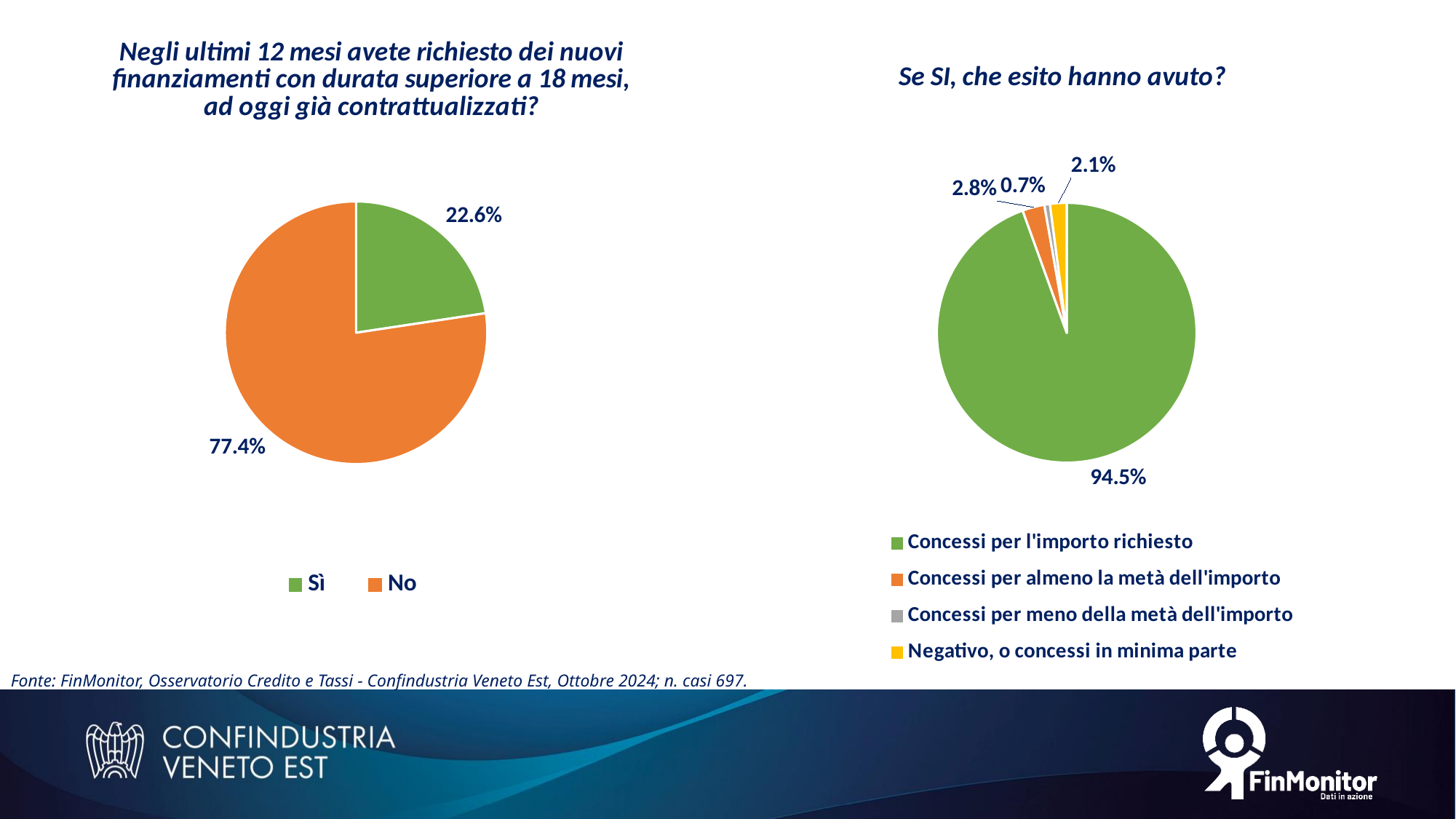
In the right pie chart, which category has the smallest share? Concessi per meno della metà dell'importo In the left pie chart, what percentage of respondents answered 'Sì'? 22.6% What type of chart is used on the left side of the slide? Pie chart In the right pie chart ('Se SI, che esito hanno avuto?'), what is the share for 'Concessi per l'importo richiesto'? 94.5% In the right pie chart, what is the share for 'Negativo, o concessi in minima parte'? 2.1% In the right pie chart, which is larger: 'Concessi per almeno la metà dell'importo' or 'Negativo, o concessi in minima parte'? Concessi per almeno la metà dell'importo In the left pie chart, which colour represents 'No'? Orange How many categories does the legend of the right pie chart list? 4 In the right pie chart, what is the share for 'Concessi per almeno la metà dell'importo'? 2.8% In the left pie chart, which category has the largest share? No In the left pie chart, what percentage of respondents answered 'No'? 77.4% In the left pie chart, what is the difference between the 'No' and 'Sì' shares? 54.8 percentage points